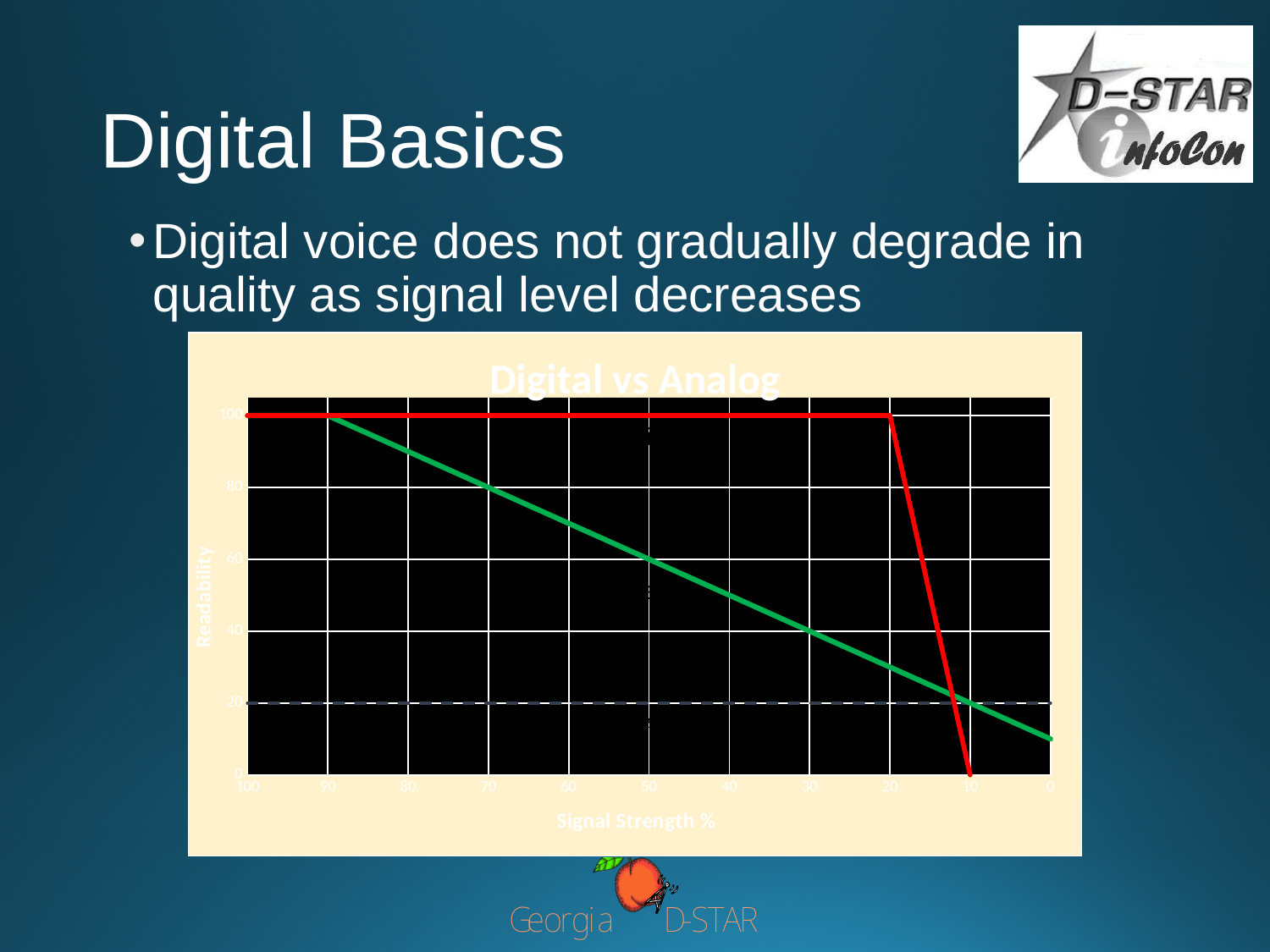
What kind of chart is shown on the slide? line chart What is the readability value of the red line at a signal strength of 50%? 100 What is the title of the chart? Digital vs Analog Is the readability of the green line at a signal strength of 0% greater or less than 20? less At a signal strength of 10%, which line has the higher readability, the red line or the green line? green line What is the readability value of the red line at a signal strength of 10%? 0 How many lines are plotted on the chart? 3 At a signal strength of 50%, which line has the higher readability, the red line or the green line? red line What is the label of the x axis of the chart? Signal Strength % Does the readability of the green line rise or fall as signal strength decreases from 100% to 0%? fall Is the readability of the green line at a signal strength of 50% greater or less than 80? less Is the readability of the green line at a signal strength of 30% greater or less than 20? greater